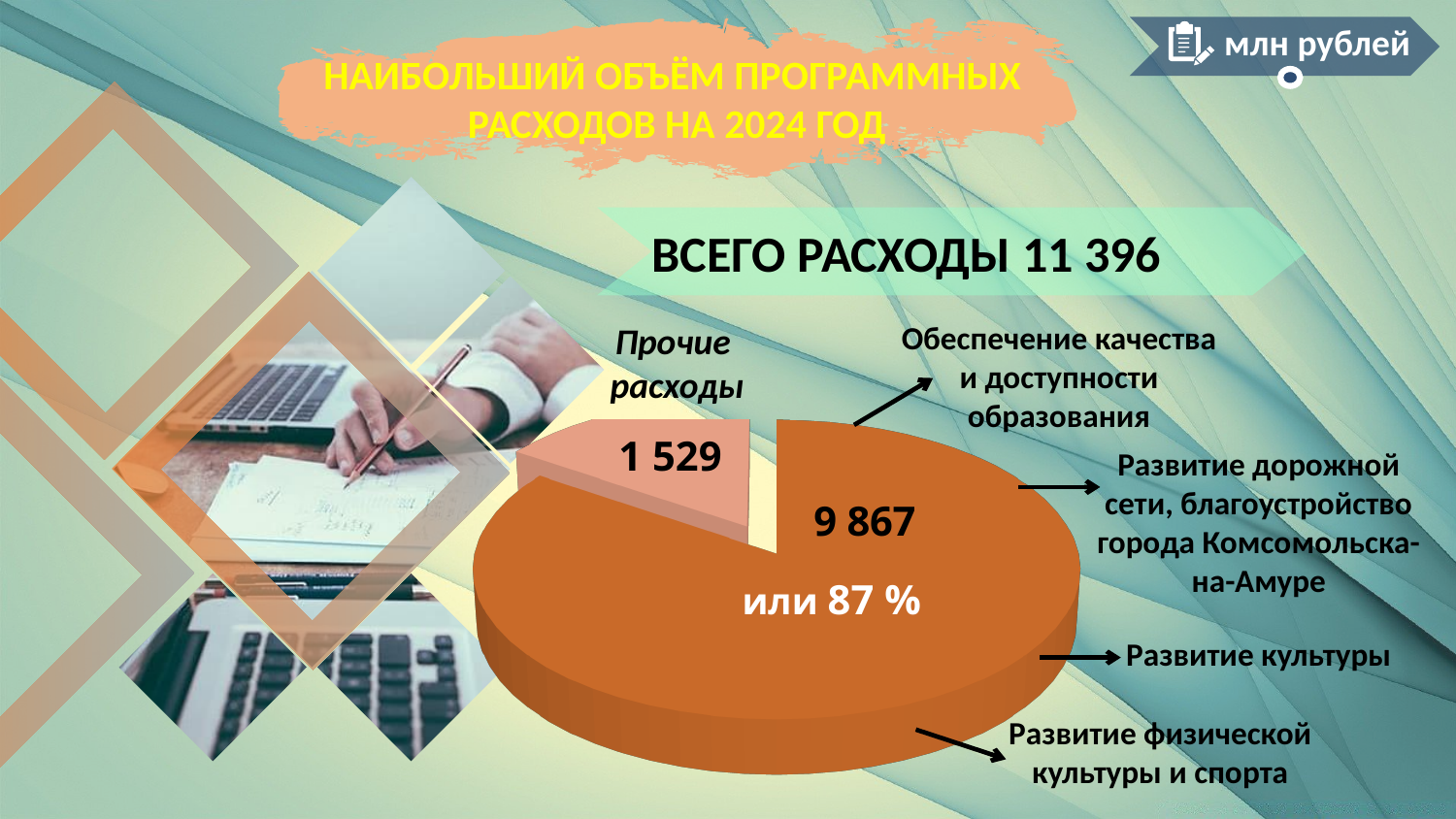
How many slices does the pie chart have? 2 Which slice of the pie is the smallest? Прочие расходы How many programme names are listed with arrows pointing to the large orange slice? 4 What share of the pie does the large orange slice represent, as printed on the slide? 87 % What is the total of expenditures shown above the chart (ВСЕГО РАСХОДЫ)? 11 396 In what units are the values on the slide expressed, according to the label in the top right corner? млн рублей What is the difference between the large slice (9 867) and the "Прочие расходы" slice (1 529)? 8 338 What is the value of the large orange slice of the pie? 9 867 What kind of chart is shown on the slide? pie chart What is the title of the slide? НАИБОЛЬШИЙ ОБЪЁМ ПРОГРАММНЫХ РАСХОДОВ НА 2024 ГОД What is the value of the "Прочие расходы" slice? 1 529 Which slice is larger: the 9 867 slice or the "Прочие расходы" slice? the 9 867 slice